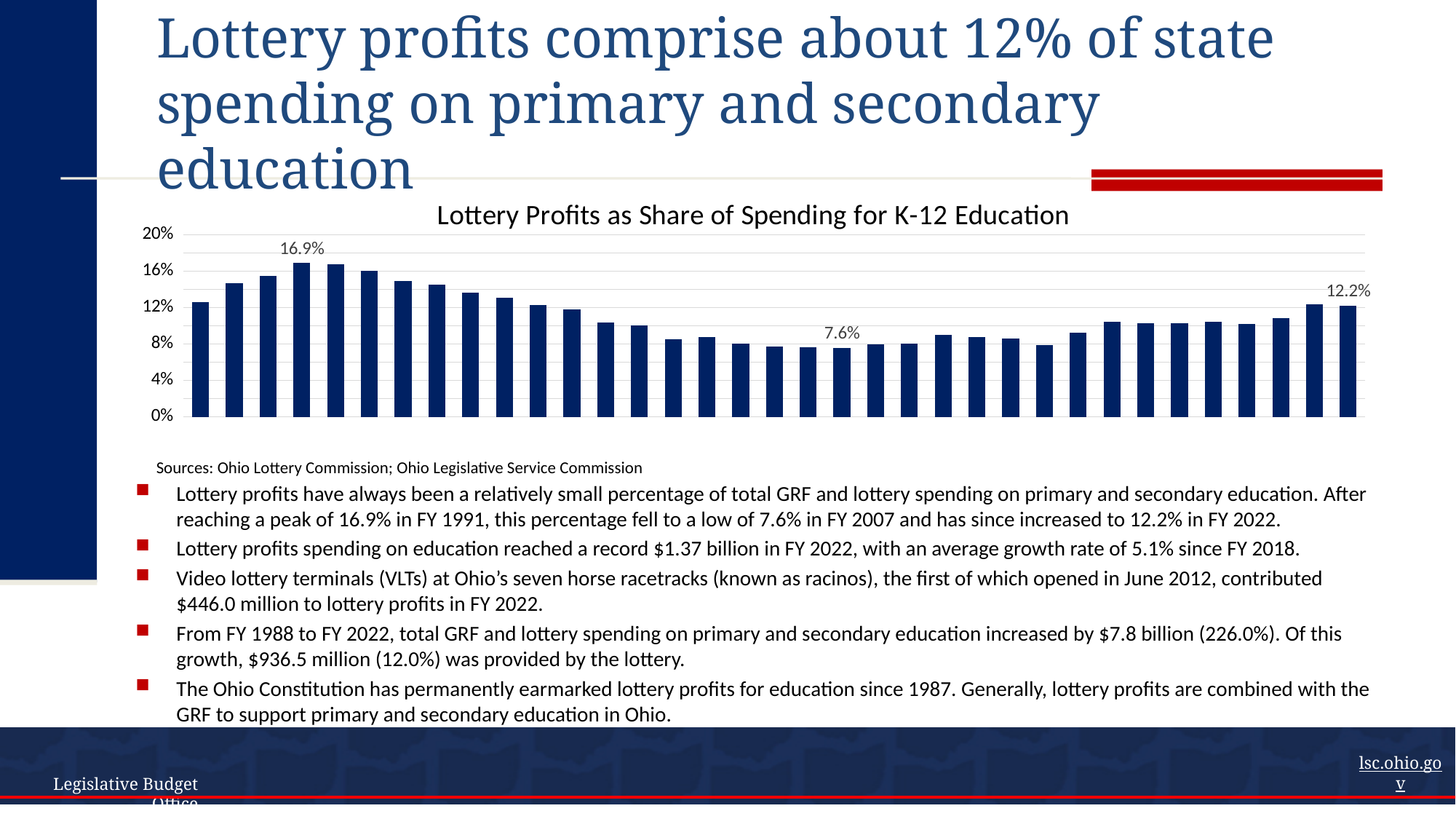
What value is labeled on the last (rightmost) bar of the chart? 12.2% What kind of chart is shown on the slide? bar chart Moving right from the tallest bar to the shortest bar, do the values rise or fall? fall Which is larger: the peak labeled value or the value labeled on the last bar? the peak labeled value (16.9%) Is the value of the tallest bar greater or less than 16%? greater What is the difference between the peak labeled value (16.9%) and the lowest labeled value (7.6%)? 9.3 percentage points What is the lowest value labeled on the chart? 7.6% What is the difference between the last bar's labeled value (12.2%) and the lowest labeled value (7.6%)? 4.6 percentage points Is the value of the shortest bar greater or less than 12%? less What is the highest value labeled on the chart? 16.9% How many bars are plotted in the chart? 35 What is the title of the chart? Lottery Profits as Share of Spending for K-12 Education